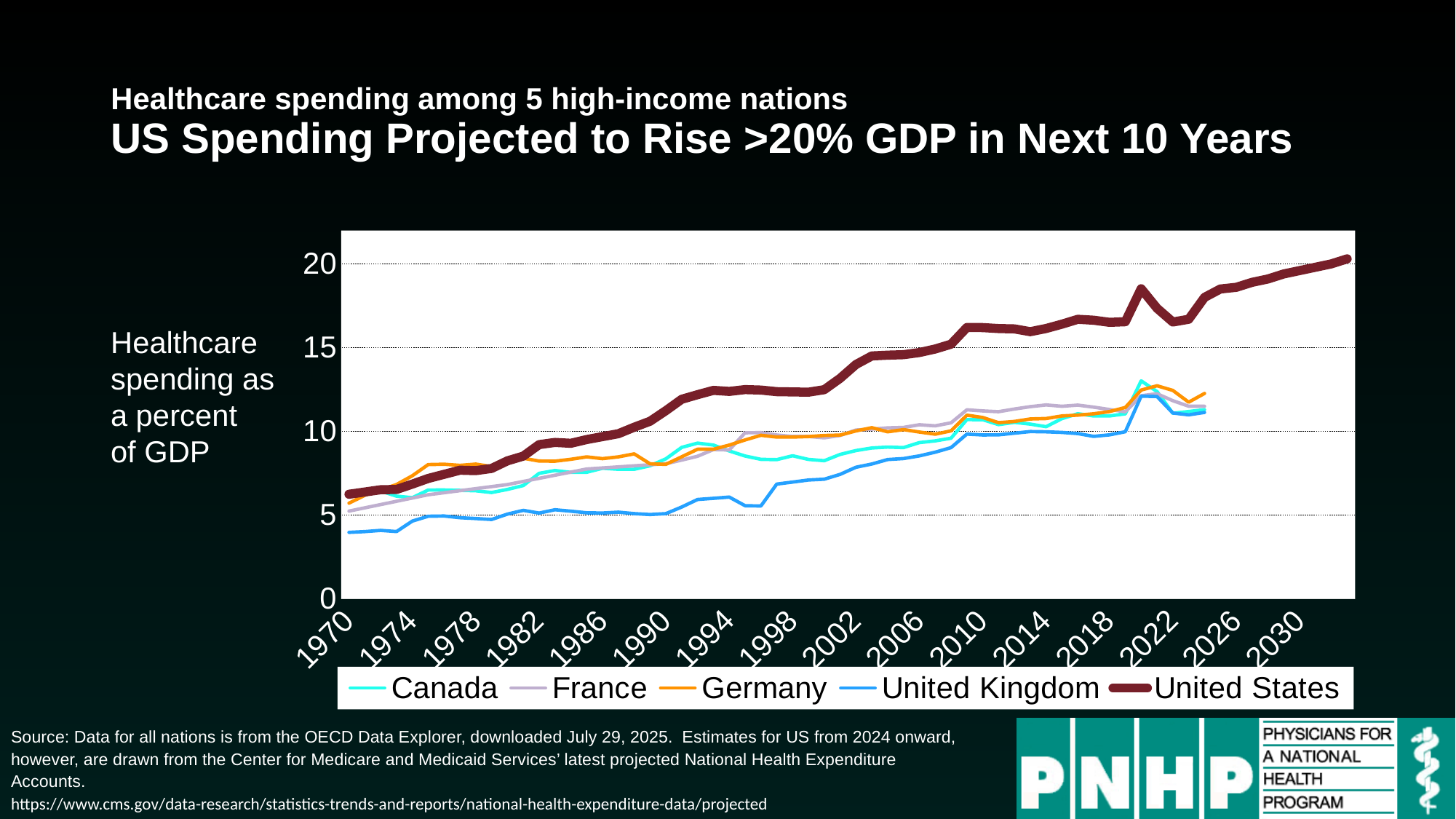
Which country has the highest healthcare spending as a percent of GDP in 2022? United States What is the label on the y axis of the chart? Healthcare spending as a percent of GDP Is the value for the United States in 1970 greater or less than 10? less Is the value for the United Kingdom in 1970 greater or less than 5? less Does the United States line rise or fall from 1970 to 2030? rise How many year labels are shown on the x axis? 16 Which countries are listed in the chart's legend? Canada, France, Germany, United Kingdom, United States Is the value for the United States in 2030 greater or less than 15? greater How many series does the legend list? 5 In 2010, which is larger: the value for the United States or the value for the United Kingdom? United States What kind of chart is shown on the slide? line chart Which country has the lowest healthcare spending as a percent of GDP in 1970? United Kingdom